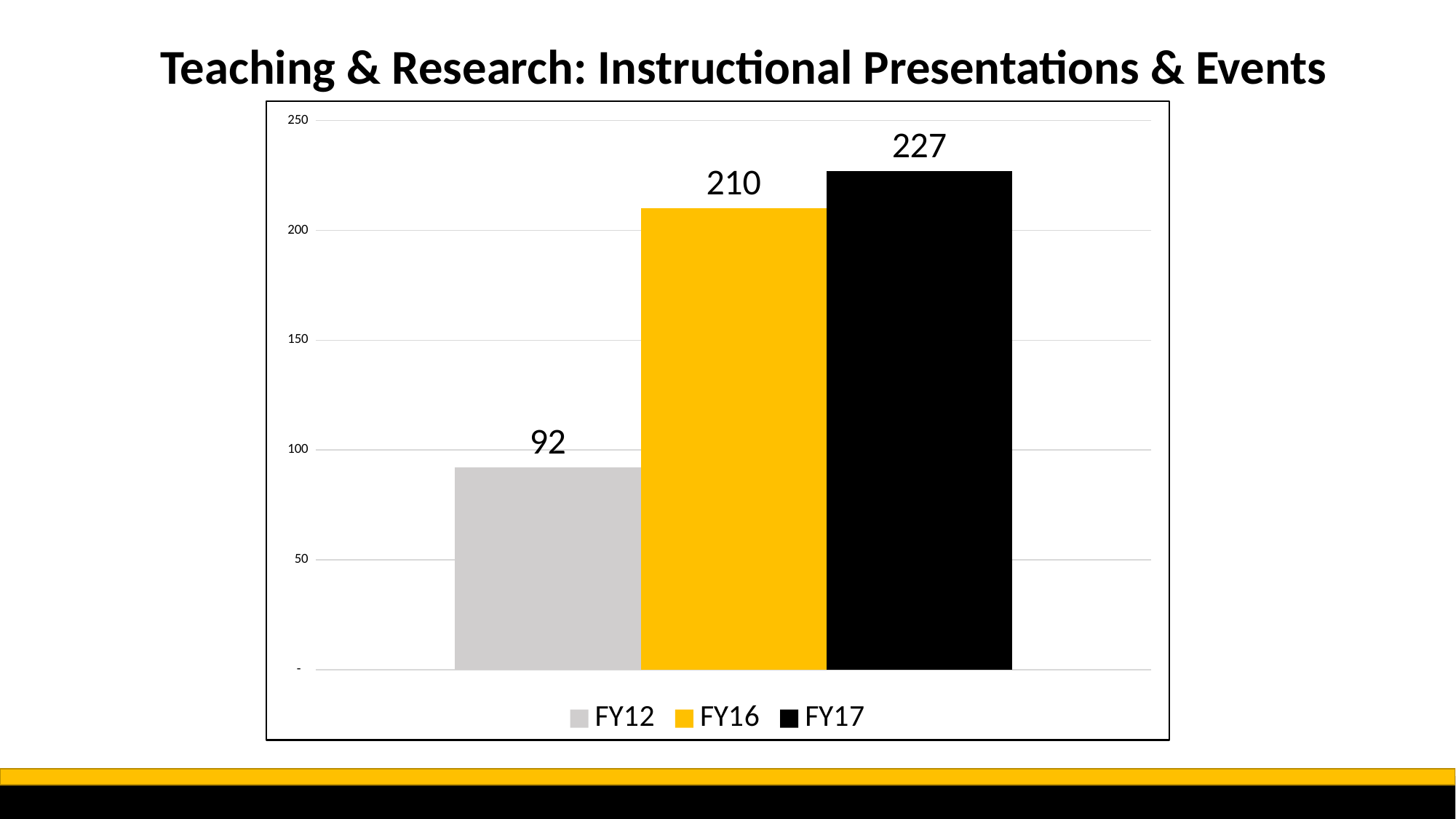
What is the title of the chart? Teaching & Research: Instructional Presentations & Events What is the difference between the FY17 and FY16 values? 17 How many series does the legend list? 3 What is the value for FY17? 227 Which series has the lowest value? FY12 What kind of chart is shown on the slide? bar chart Which series has the highest value? FY17 Which is larger, the value for FY12 or the value for FY16? FY16 Is the value for FY12 greater or less than 100? less What is the value for FY12? 92 What is the difference between the FY16 and FY12 values? 118 What is the value for FY16? 210